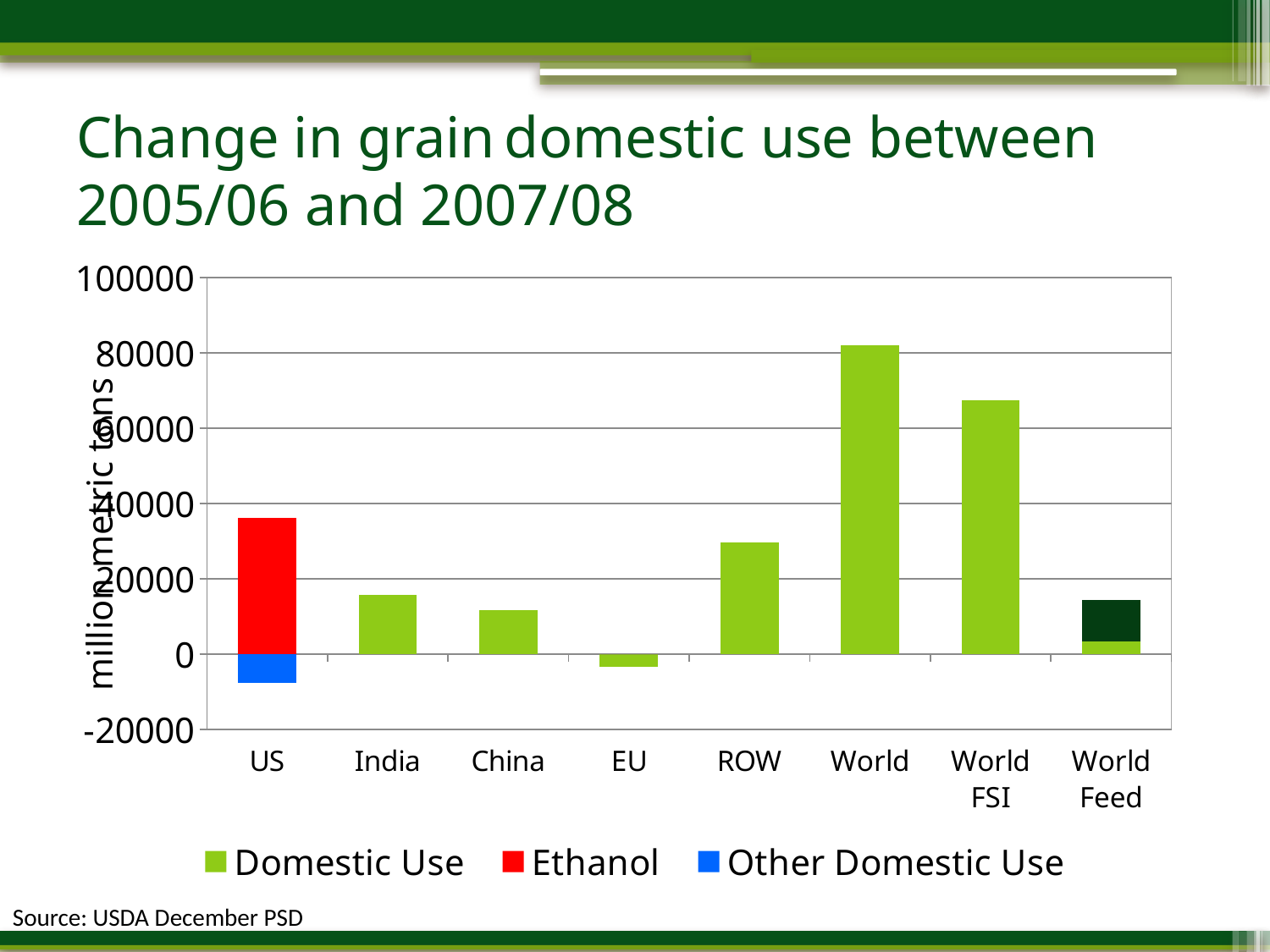
How many series does the chart's legend list? 3 What is the label on the y axis of the chart? million metric tons Is the Domestic Use value for ROW greater or less than 20000? greater What is the title of the chart on the slide? Change in grain domestic use between 2005/06 and 2007/08 Which is larger, the value for World or the value for World FSI? World Which category has the lowest Domestic Use value in the chart? EU Which is larger, the Domestic Use value for India or for China? India What kind of chart is shown on the slide? bar chart Is the value for World FSI greater or less than 60000? greater How many categories are shown on the x axis of the chart? 8 Is the Ethanol value for US greater or less than 40000? less Which category has the highest value in the chart? World